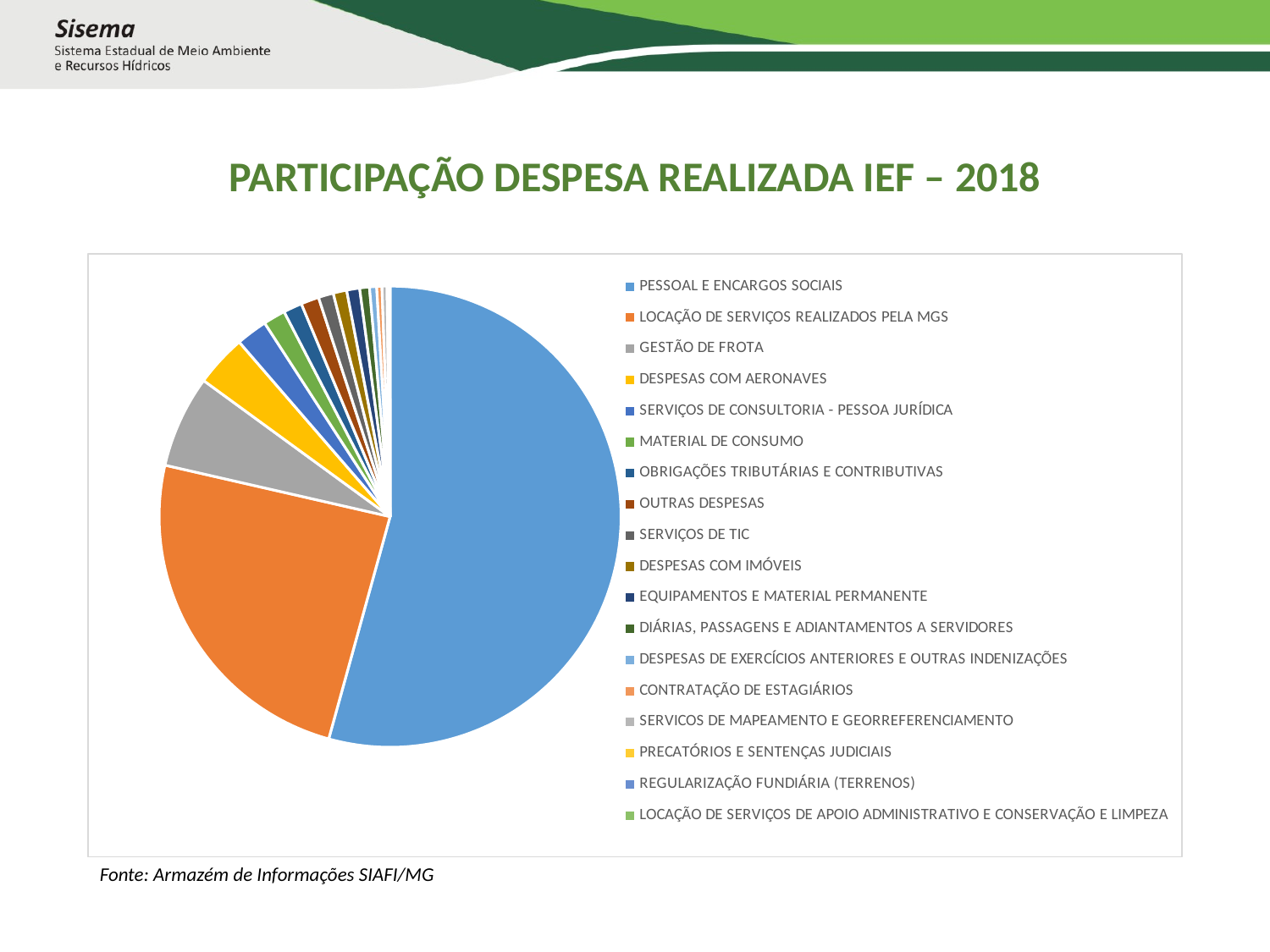
Which category has the second-largest slice of the pie? LOCAÇÃO DE SERVIÇOS REALIZADOS PELA MGS Which category has the largest slice of the pie? PESSOAL E ENCARGOS SOCIAIS Which slice is larger: PESSOAL E ENCARGOS SOCIAIS or LOCAÇÃO DE SERVIÇOS REALIZADOS PELA MGS? PESSOAL E ENCARGOS SOCIAIS What kind of chart is shown on the slide? Pie chart Which slice is larger: GESTÃO DE FROTA or DESPESAS COM AERONAVES? GESTÃO DE FROTA Does the largest slice, PESSOAL E ENCARGOS SOCIAIS, account for more or less than half of the pie? More How many categories does the legend of the pie chart list? 18 What is the title of the chart on the slide? PARTICIPAÇÃO DESPESA REALIZADA IEF – 2018 What colour is the slice for LOCAÇÃO DE SERVIÇOS REALIZADOS PELA MGS? Orange